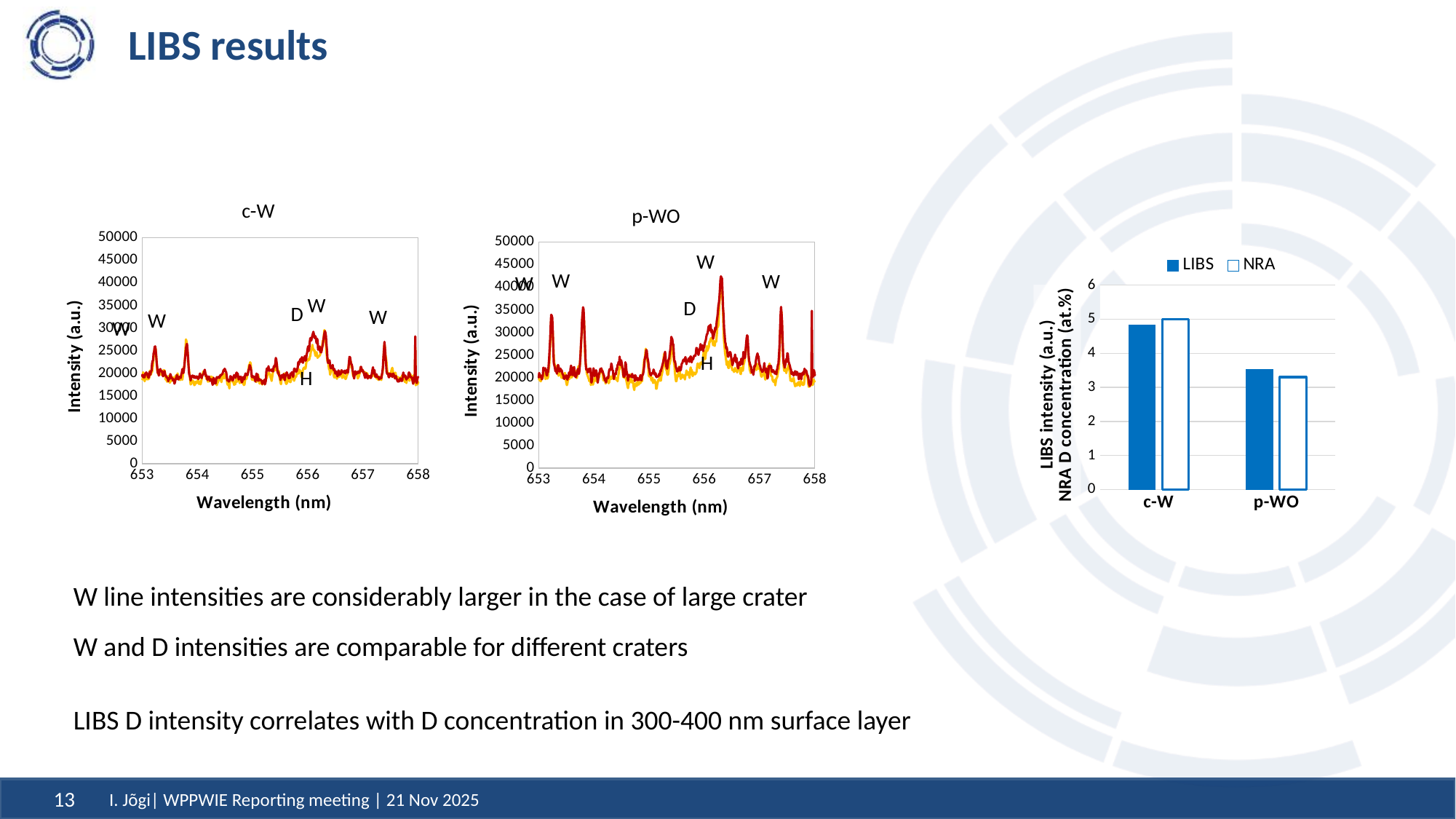
How many categories are shown on the x axis of the bar chart on the right? 2 In the bar chart on the right, which category has the lower NRA value? p-WO In the bar chart on the right, which category has the higher LIBS value, c-W or p-WO? c-W How many series does the legend of the bar chart on the right list? 2 In the bar chart on the right, is the NRA value for p-WO greater or less than 4? less What are the two series named in the legend of the bar chart on the right? LIBS and NRA What kind of chart is the chart titled c-W? line chart What is the x-axis label of the chart titled c-W? Wavelength (nm) What is the maximum value shown on the y axis of the chart titled p-WO? 50000 In the bar chart on the right, is the LIBS value for c-W greater or less than 4? greater In the bar chart on the right, is the LIBS value for p-WO greater or less than 3? greater What kind of chart is the chart on the right of the slide with categories c-W and p-WO? bar chart